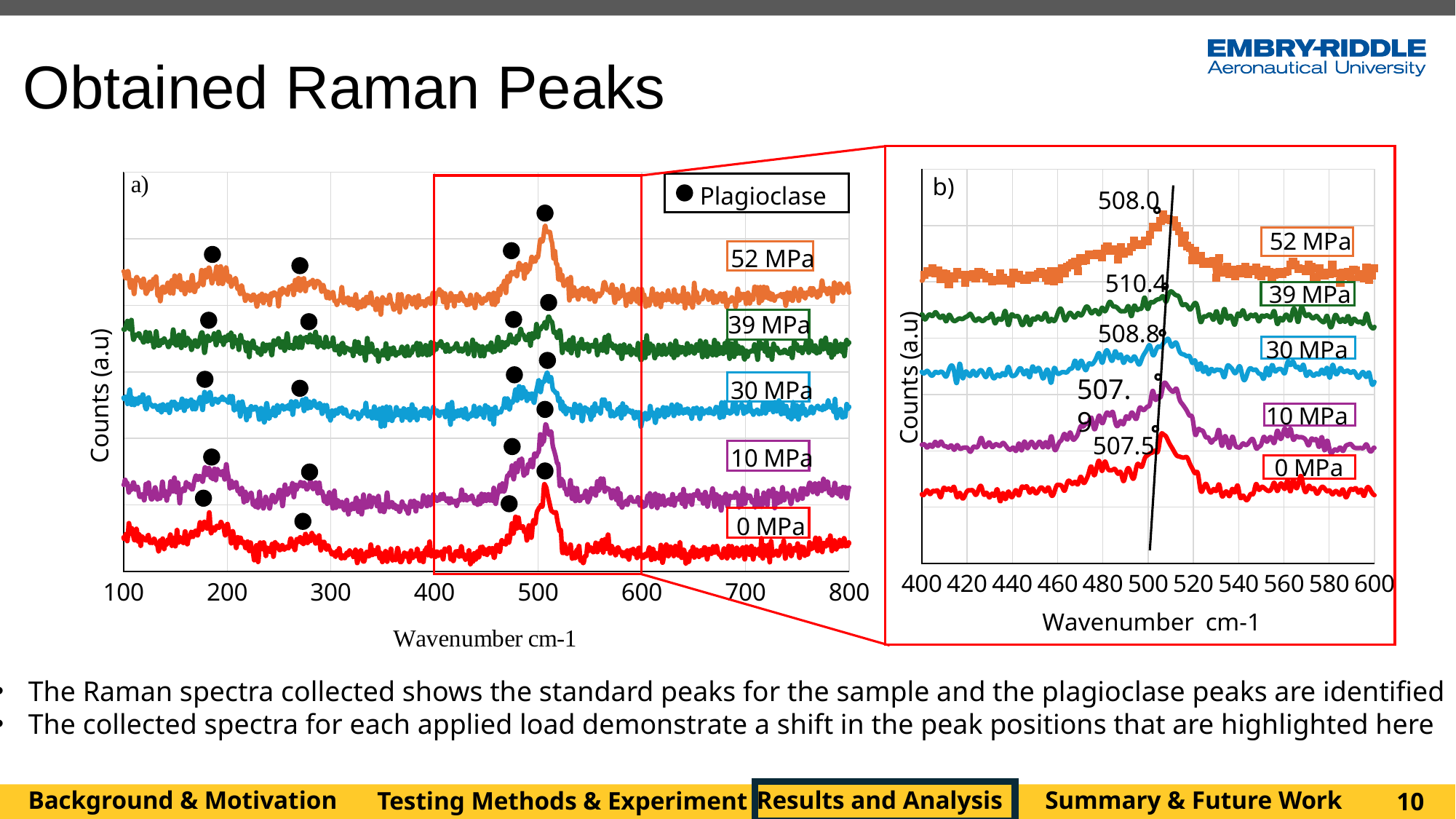
In chart b) on the right, what peak position is labelled for the 52 MPa spectrum? 508.0 In chart b) on the right, which applied load has the highest labelled peak position? 39 MPa In chart b) on the right, which has the larger labelled peak position, 30 MPa or 52 MPa? 30 MPa In chart b) on the right, what peak position is labelled for the 39 MPa spectrum? 510.4 In chart b) on the right, what is the difference between the labelled peak positions for 39 MPa and 0 MPa? 2.9 In chart b) on the right, what peak position is labelled for the 30 MPa spectrum? 508.8 What does the black dot marker in the legend of chart a) on the left identify? Plagioclase What kind of chart is chart a) on the left? line chart How many applied-load spectra are plotted in chart a) on the left? 5 In chart b) on the right, what peak position is labelled for the 0 MPa spectrum? 507.5 What is the label of the y axis in chart a) on the left? Counts (a.u) In chart b) on the right, which applied load has the lowest labelled peak position? 0 MPa